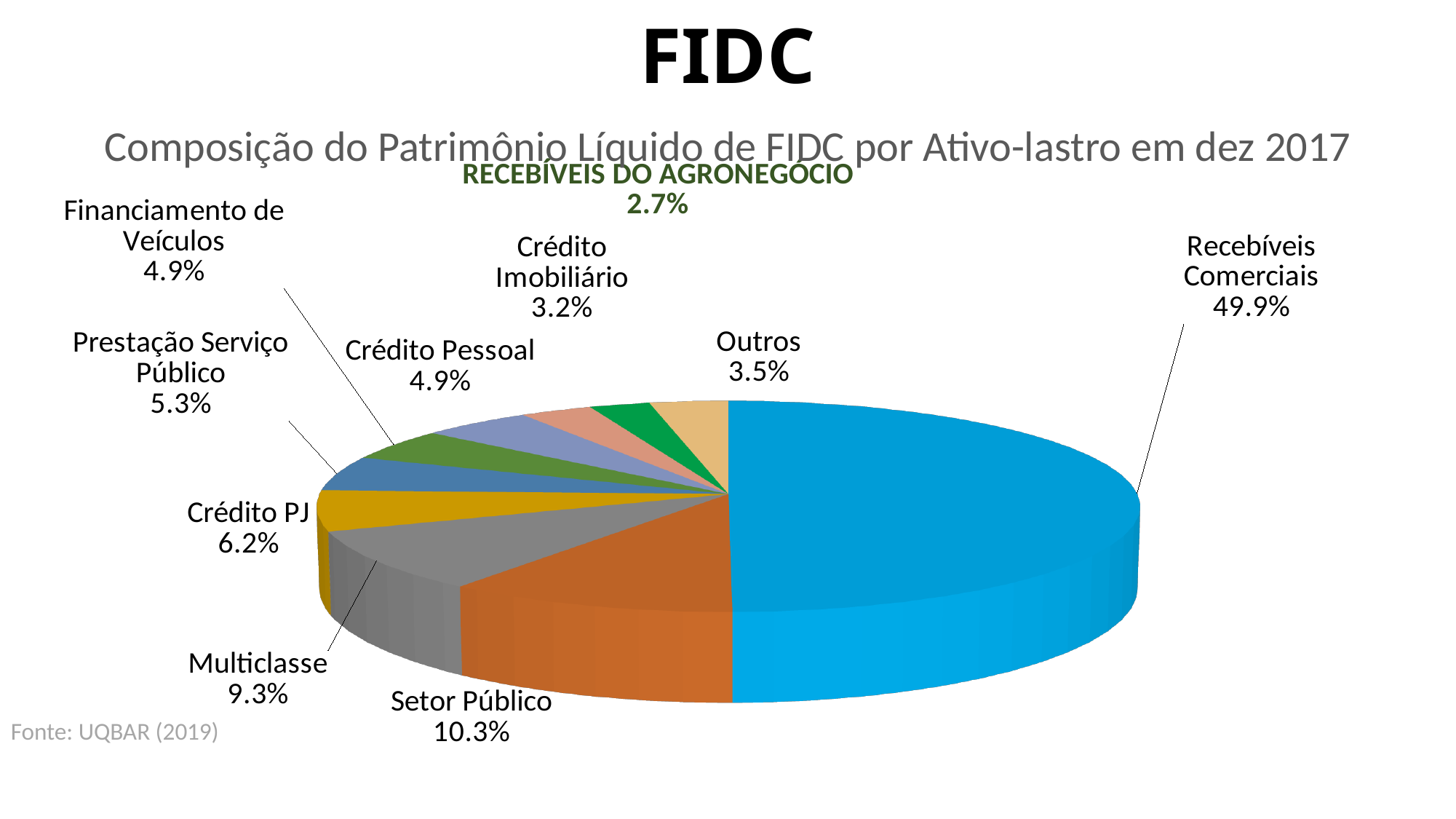
What is the value shown for Recebíveis do Agronegócio? 2.7% Which category has the largest slice of the pie? Recebíveis Comerciais What is the difference between the shares of Setor Público and Multiclasse? 1.0% What is the value shown for Multiclasse? 9.3% What kind of chart is shown on the slide? Pie chart How many slices does the pie chart have? 10 What is the title of the chart? Composição do Patrimônio Líquido de FIDC por Ativo-lastro em dez 2017 What share of the pie does Recebíveis Comerciais hold? 49.9% Which is larger, Crédito PJ or Prestação Serviço Público? Crédito PJ Which category has the smallest slice of the pie? Recebíveis do Agronegócio What is the difference between the shares of Outros and Crédito Imobiliário? 0.3% What is the value shown for Setor Público? 10.3%